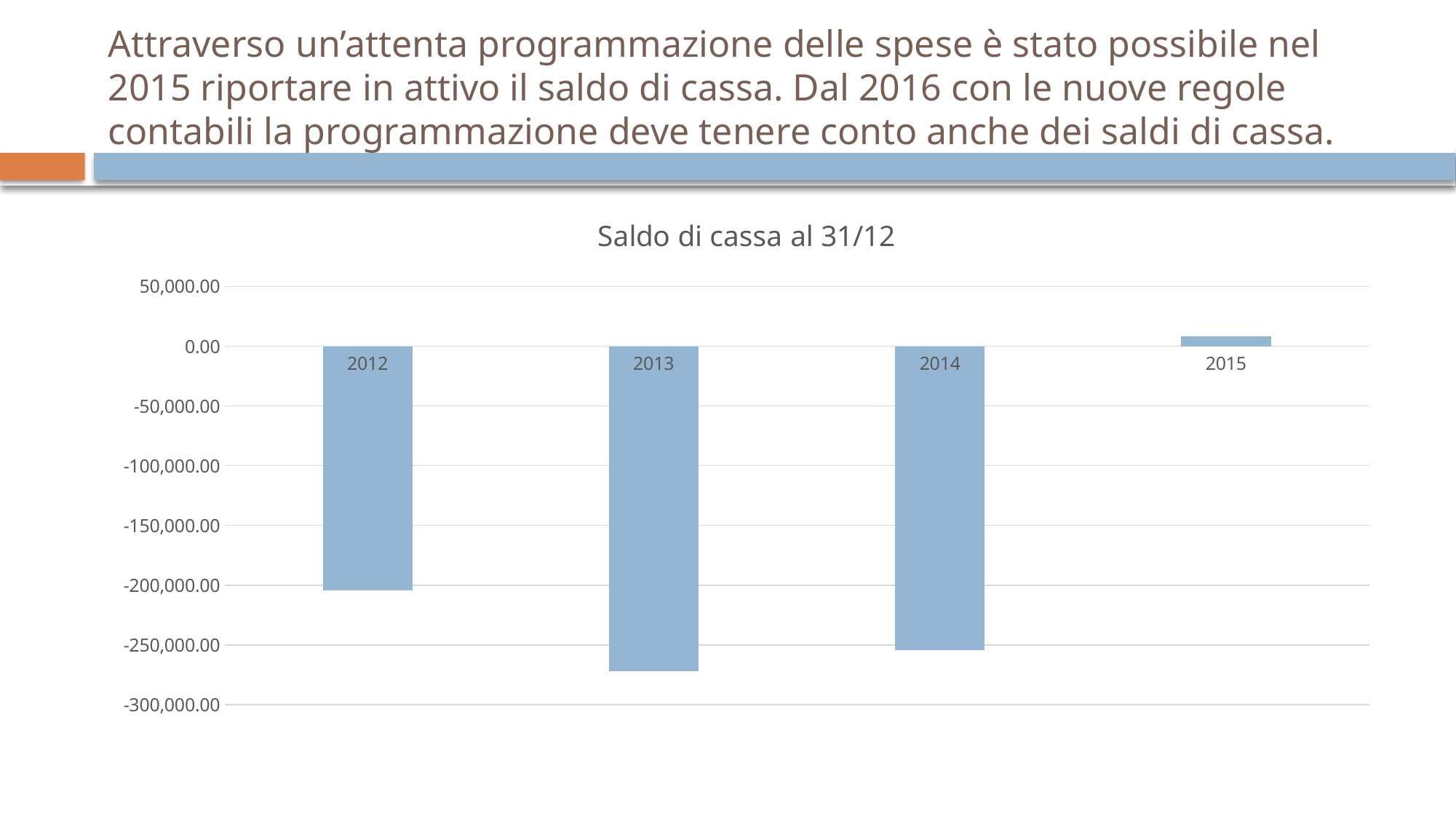
What is the title of the chart? Saldo di cassa al 31/12 How many years are plotted in the chart? 4 Is the value for 2013 greater or less than -250,000.00? less Which year has the highest saldo di cassa? 2015 Which is larger, the value for 2014 or the value for 2013? 2014 Is the value for 2014 greater or less than -300,000.00? greater What type of chart is shown on the slide? bar chart Is the value for 2015 greater or less than 0.00? greater How many years in the chart have a negative saldo di cassa? 3 Which year has the lowest saldo di cassa? 2013 Which is larger, the value for 2012 or the value for 2013? 2012